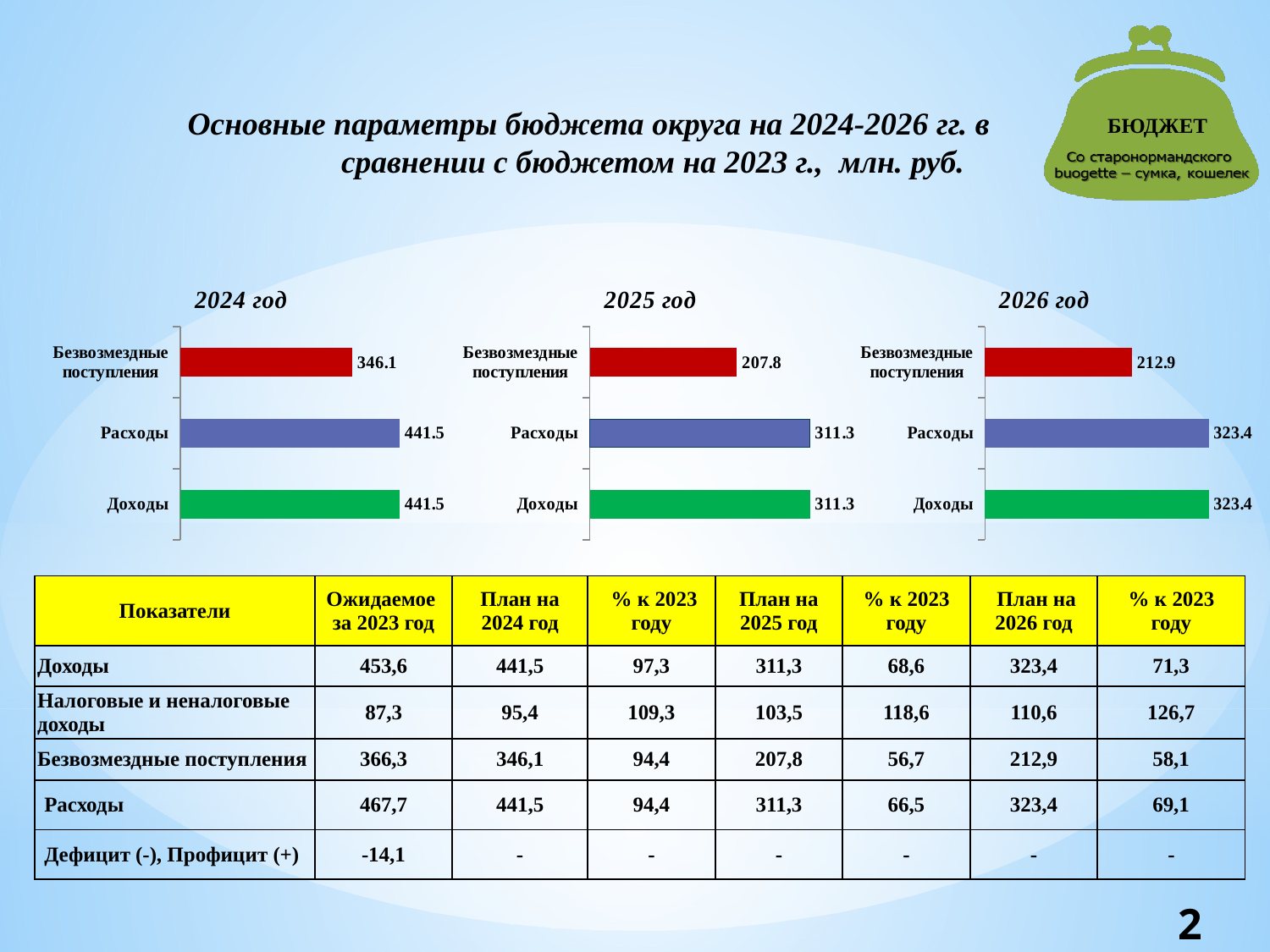
In the 2026 год chart, what is the value for Доходы? 323.4 How many categories are shown in the 2025 год chart? 3 How many bar charts are on the slide? 3 In the 2025 год chart, what is the value for Расходы? 311.3 In the 2025 год chart, what colour is the bar for Доходы? green In the 2024 год chart, which category has the lowest value? Безвозмездные поступления In the 2024 год chart, what is the difference between Расходы and Безвозмездные поступления? 95.4 In the 2025 год chart, what is the difference between Доходы and Безвозмездные поступления? 103.5 What kind of chart is the 2024 год chart? bar chart In the 2024 год chart, what is the value for Безвозмездные поступления? 346.1 In the 2026 год chart, what is the value for Безвозмездные поступления? 212.9 In the 2026 год chart, which is larger, Расходы or Безвозмездные поступления? Расходы